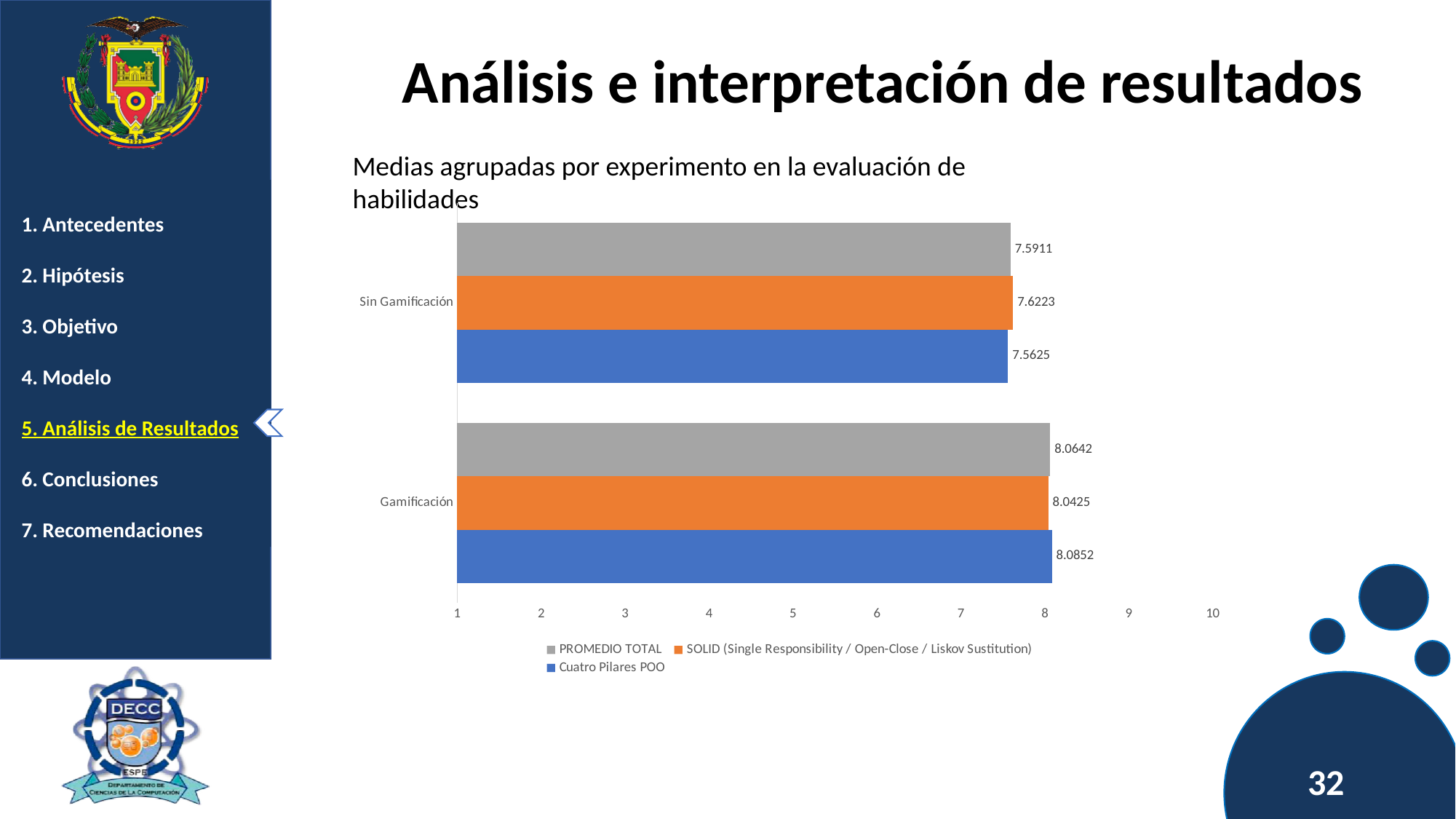
How many series does the legend list? 3 What is the PROMEDIO TOTAL value for Gamificación? 8.0642 What is the difference between the PROMEDIO TOTAL values for Gamificación and Sin Gamificación? 0.4731 What is the SOLID (Single Responsibility / Open-Close / Liskov Sustitution) value for Sin Gamificación? 7.6223 How many categories are shown on the chart? 2 Which series has the lowest value for Sin Gamificación? Cuatro Pilares POO What kind of chart is shown on the slide? Bar chart Which series has the highest value for Gamificación? Cuatro Pilares POO What is the difference between the Cuatro Pilares POO values for Gamificación and Sin Gamificación? 0.5227 What is the Cuatro Pilares POO value for Gamificación? 8.0852 Which is larger, the SOLID value for Gamificación or the SOLID value for Sin Gamificación? Gamificación What is the PROMEDIO TOTAL value for Sin Gamificación? 7.5911